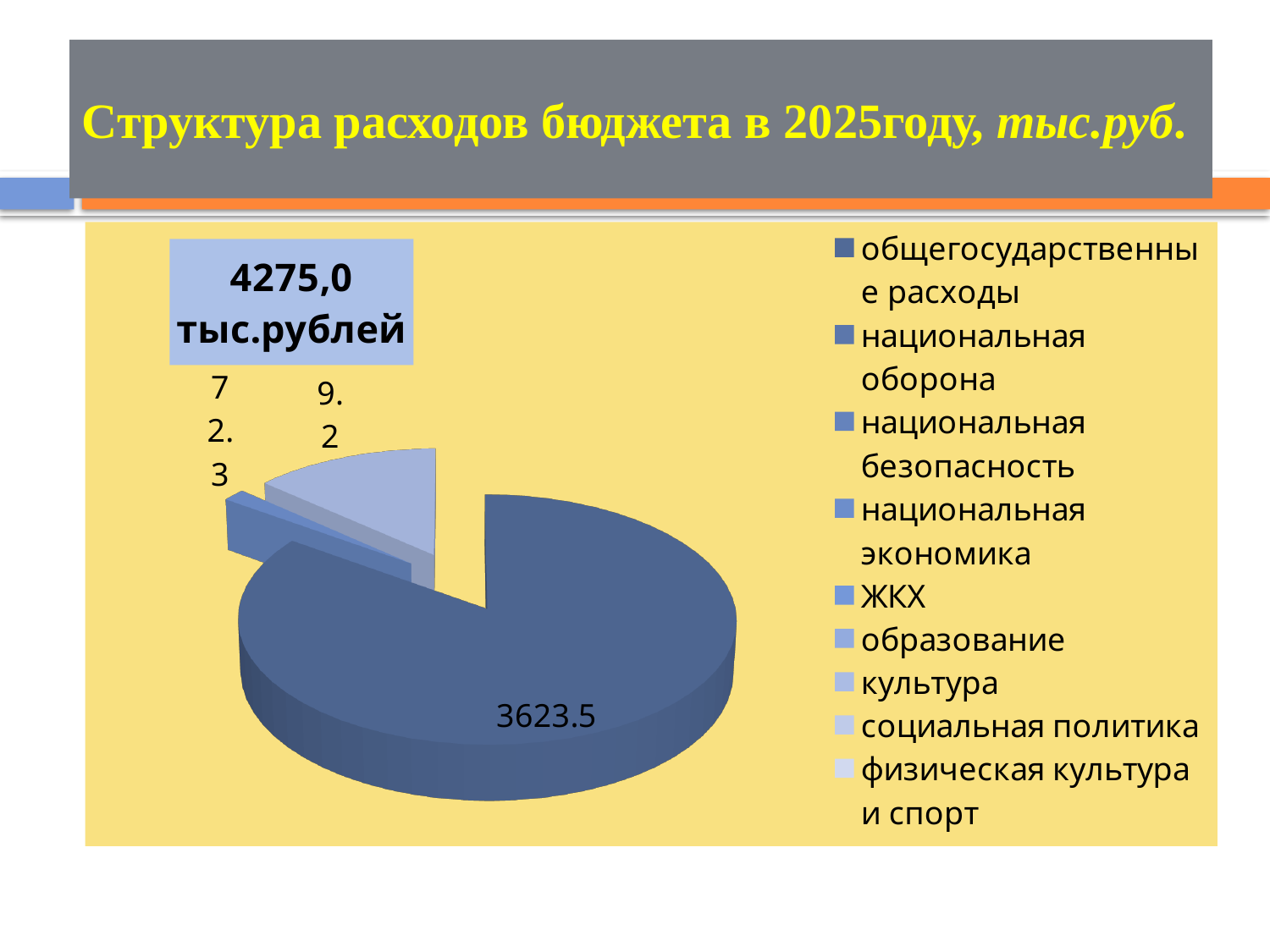
What value is printed on the largest slice of the pie chart? 3623.5 What kind of chart is shown on the slide? pie chart What total amount is shown in the text box above the pie chart? 4275,0 тыс.рублей Which category has the largest slice of the pie chart? общегосударственные расходы What is the title of the chart on the slide? 4275,0 тыс.рублей What is the value for общегосударственные расходы in the pie chart? 3623.5 How many categories does the legend of the pie chart list? 9